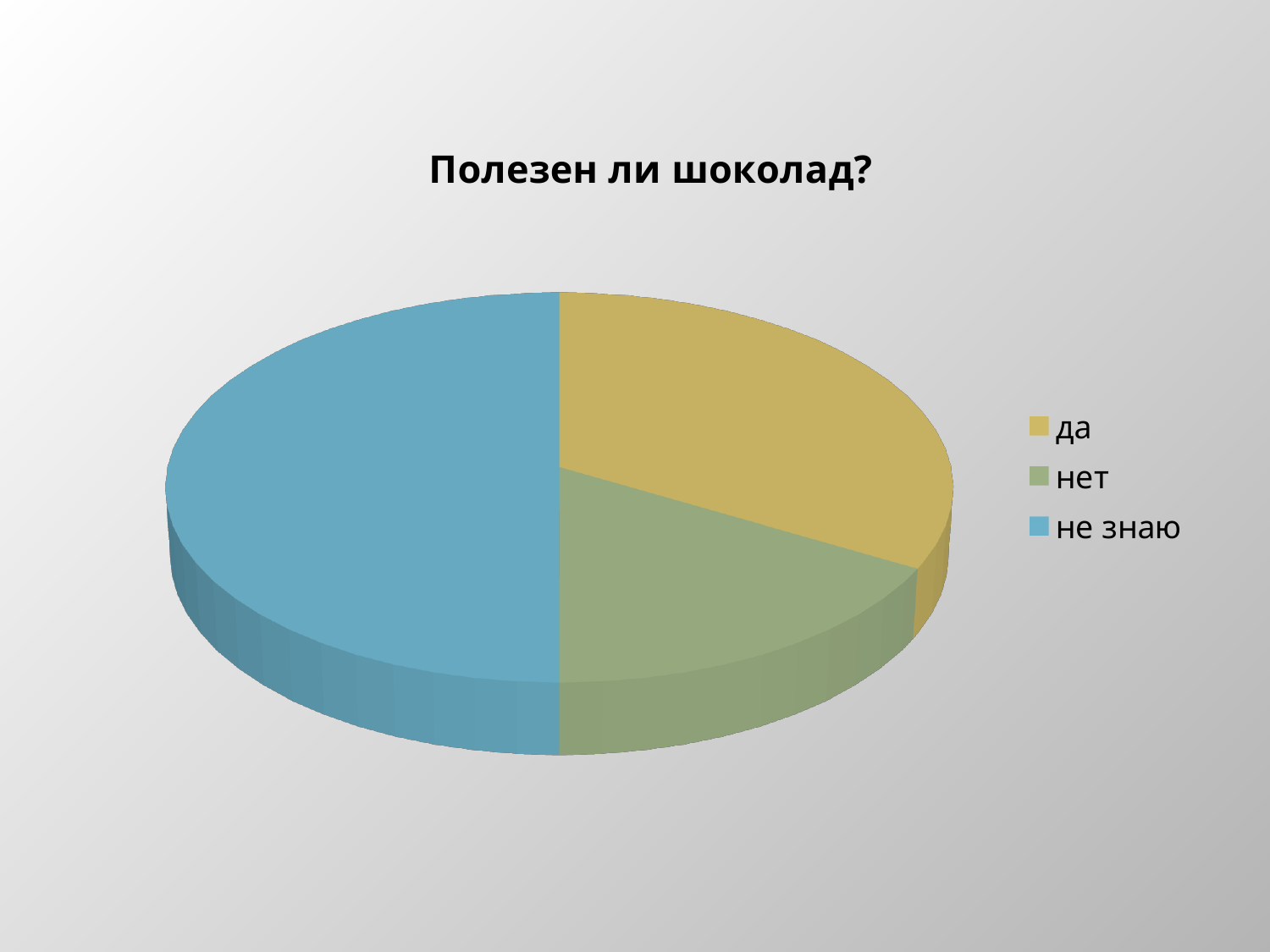
Which slice is larger, "да" or "нет"? да Which colour represents the "не знаю" category in the chart? blue How many entries does the legend list? 3 Which slice is larger, "не знаю" or "да"? не знаю Which category has the smallest slice of the pie? нет Which category has the largest slice of the pie? не знаю How many slices does the pie chart have? 3 What is the title of the chart? Полезен ли шоколад? What kind of chart is shown on the slide? pie chart